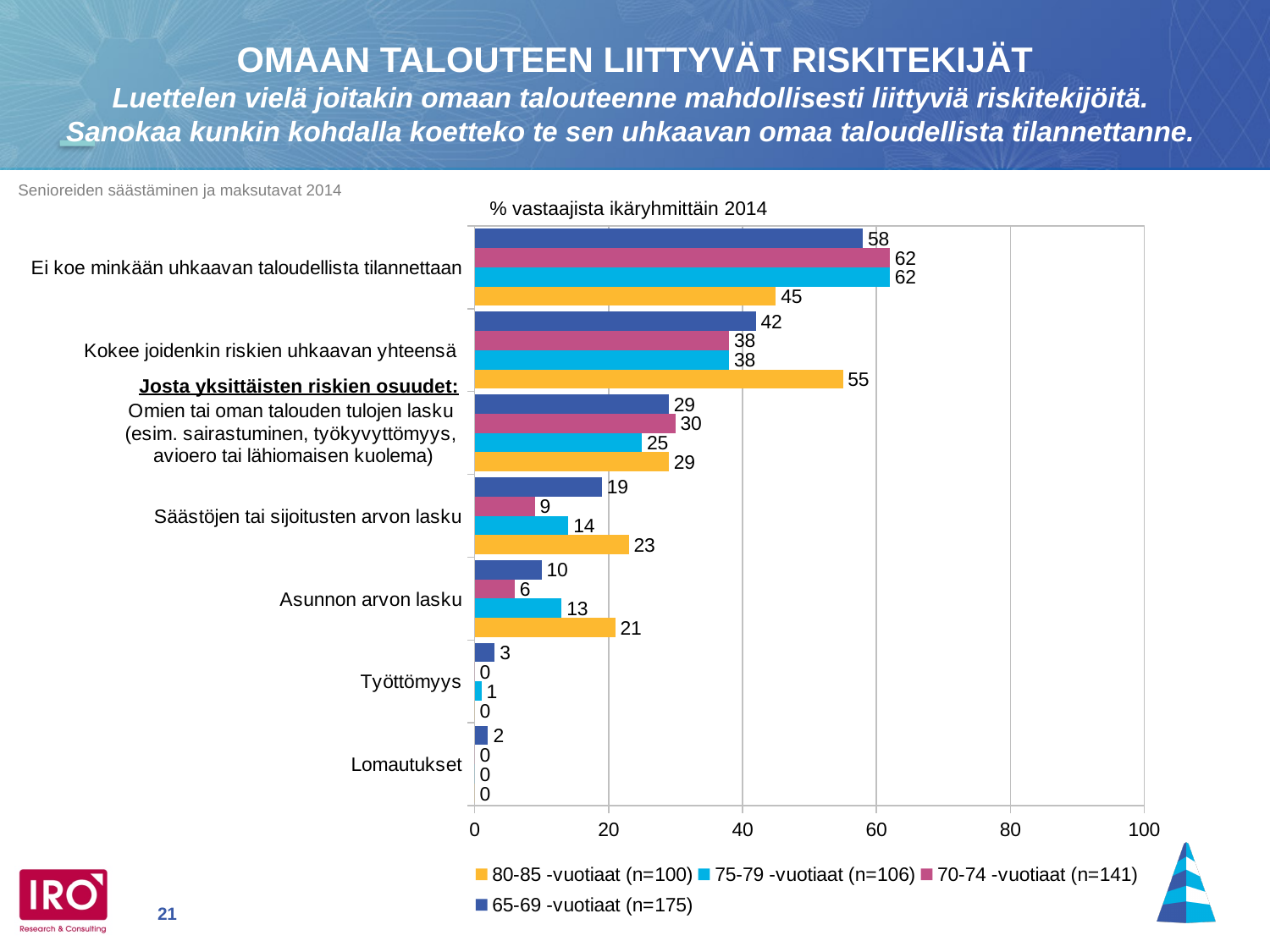
Which age group has the highest value in the category 'Asunnon arvon lasku'? 80-85 -vuotiaat (n=100) What is the value for 70-74 -vuotiaat in the category 'Säästöjen tai sijoitusten arvon lasku'? 9 What is the difference between the 80-85 -vuotiaat value and the 70-74 -vuotiaat value in the category 'Asunnon arvon lasku'? 15 What is the value for 65-69 -vuotiaat in the category 'Ei koe minkään uhkaavan taloudellista tilannettaan'? 58 In the category 'Ei koe minkään uhkaavan taloudellista tilannettaan', which is larger: the value for 65-69 -vuotiaat or for 80-85 -vuotiaat? 65-69 -vuotiaat What is the value for 80-85 -vuotiaat in the category 'Kokee joidenkin riskien uhkaavan yhteensä'? 55 What is the title shown above the chart? % vastaajista ikäryhmittäin 2014 What is the value for 75-79 -vuotiaat in the category 'Työttömyys'? 1 What type of chart is shown on the slide? bar chart Which age group has the lowest value in the category 'Kokee joidenkin riskien uhkaavan yhteensä'? 70-74 -vuotiaat and 75-79 -vuotiaat (both 38) How many series does the legend list? 4 How many categories are shown on the chart? 7